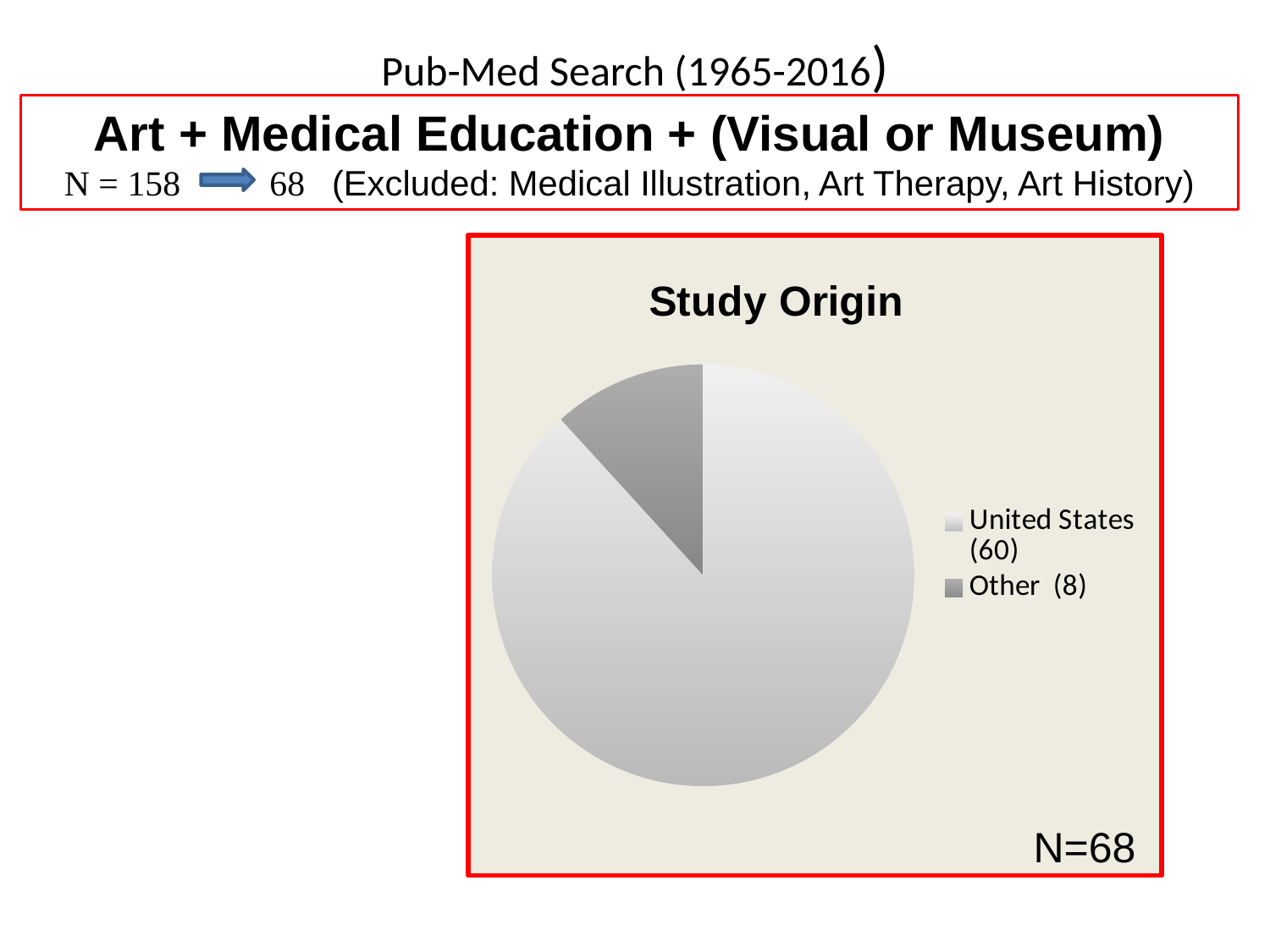
What is the title of the chart? Study Origin Which is larger, the value for United States or the value for Other? United States How many entries does the legend list? 2 How many slices does the pie chart have? 2 What is the difference between the United States and Other values? 52 What is the total N shown for the pie chart? N=68 Which category has the largest slice of the pie? United States What is the value for United States in the pie chart? 60 What is the value for Other in the pie chart? 8 Which slice is shown in the darker grey colour? Other What type of chart is shown on the slide? pie chart Which category has the smallest slice of the pie? Other